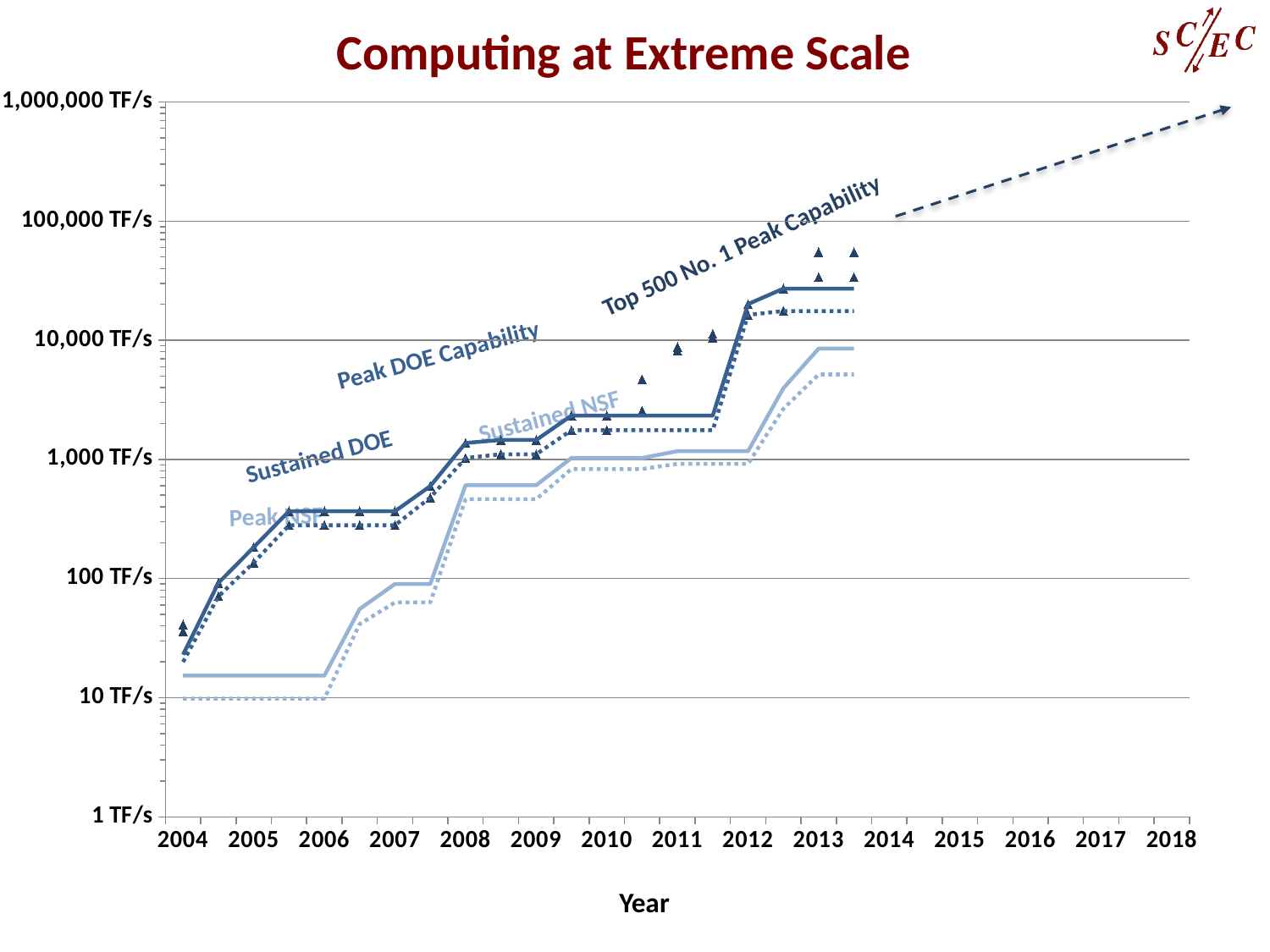
How many named series are labelled on the chart? 5 In 2013, which is higher: Peak DOE Capability or Peak NSF? Peak DOE Capability What is the title of the chart? Computing at Extreme Scale Is the Sustained DOE value in 2006 greater or less than 100 TF/s? greater How many year ticks are shown on the x axis? 15 What is the label of the x axis? Year Is the Peak DOE Capability value in 2013 greater or less than 10,000 TF/s? greater Is the Peak NSF value in 2008 greater or less than 1,000 TF/s? less Do the Peak DOE Capability values rise or fall from 2004 to 2013? Rise What kind of chart is shown on the slide? Line chart Which series has the lowest values in 2004? Sustained NSF